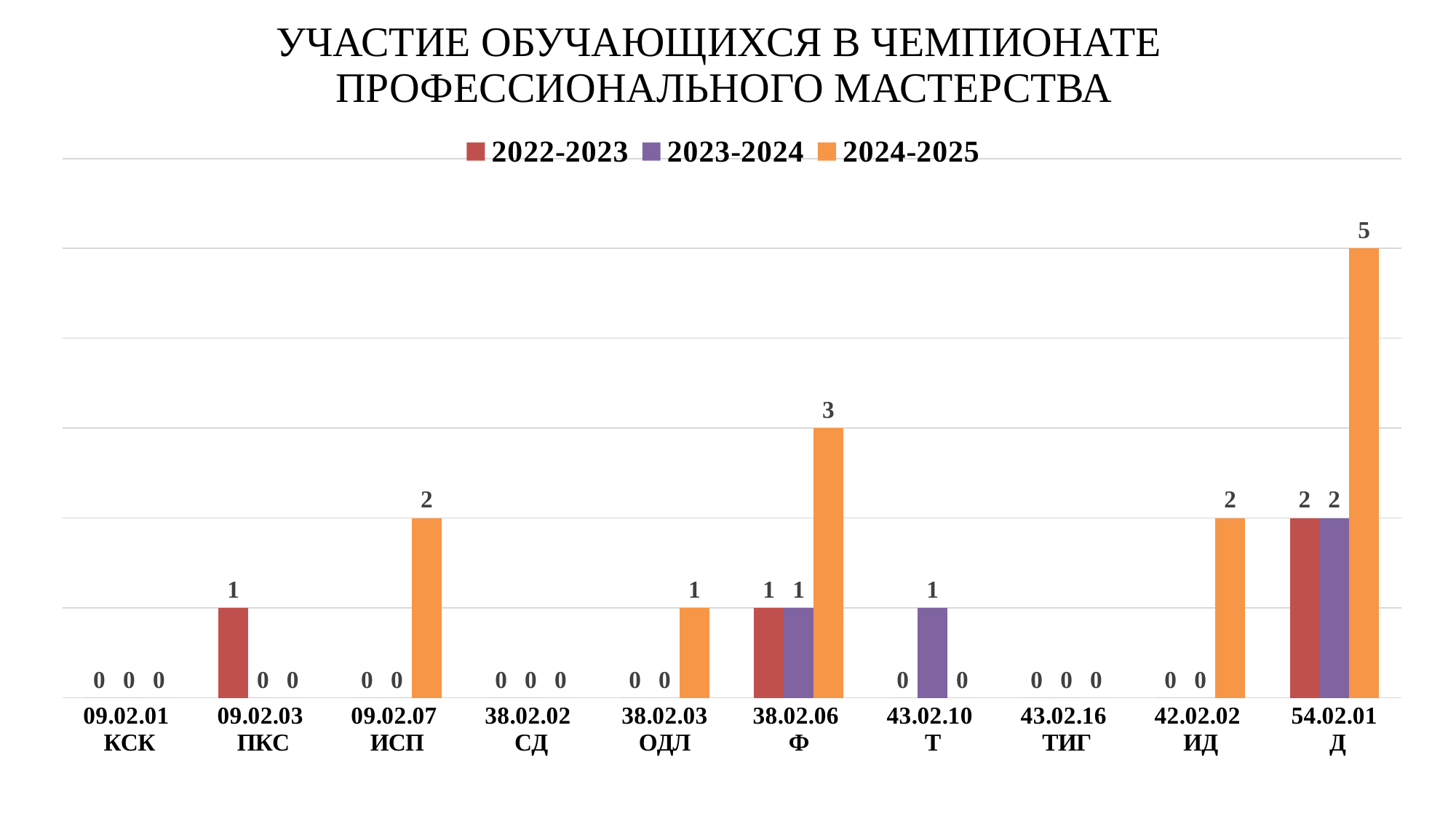
Which category has the highest value in the 2024-2025 series? 54.02.01 Д What is the difference between the 2024-2025 values for 54.02.01 Д and 38.02.06 Ф? 2 What is the value for 38.02.06 Ф in the 2024-2025 series? 3 What is the value for 09.02.03 ПКС in the 2022-2023 series? 1 Which legend entry is shown in orange? 2024-2025 What is the value for 54.02.01 Д in the 2024-2025 series? 5 Which is larger: the 2024-2025 value for 09.02.07 ИСП or the 2024-2025 value for 38.02.03 ОДЛ? 09.02.07 ИСП What is the total of the three series values for 54.02.01 Д? 9 What is the value for 43.02.10 Т in the 2023-2024 series? 1 What type of chart is shown on the slide? bar chart How many series does the legend list? 3 How many categories are shown on the x axis? 10